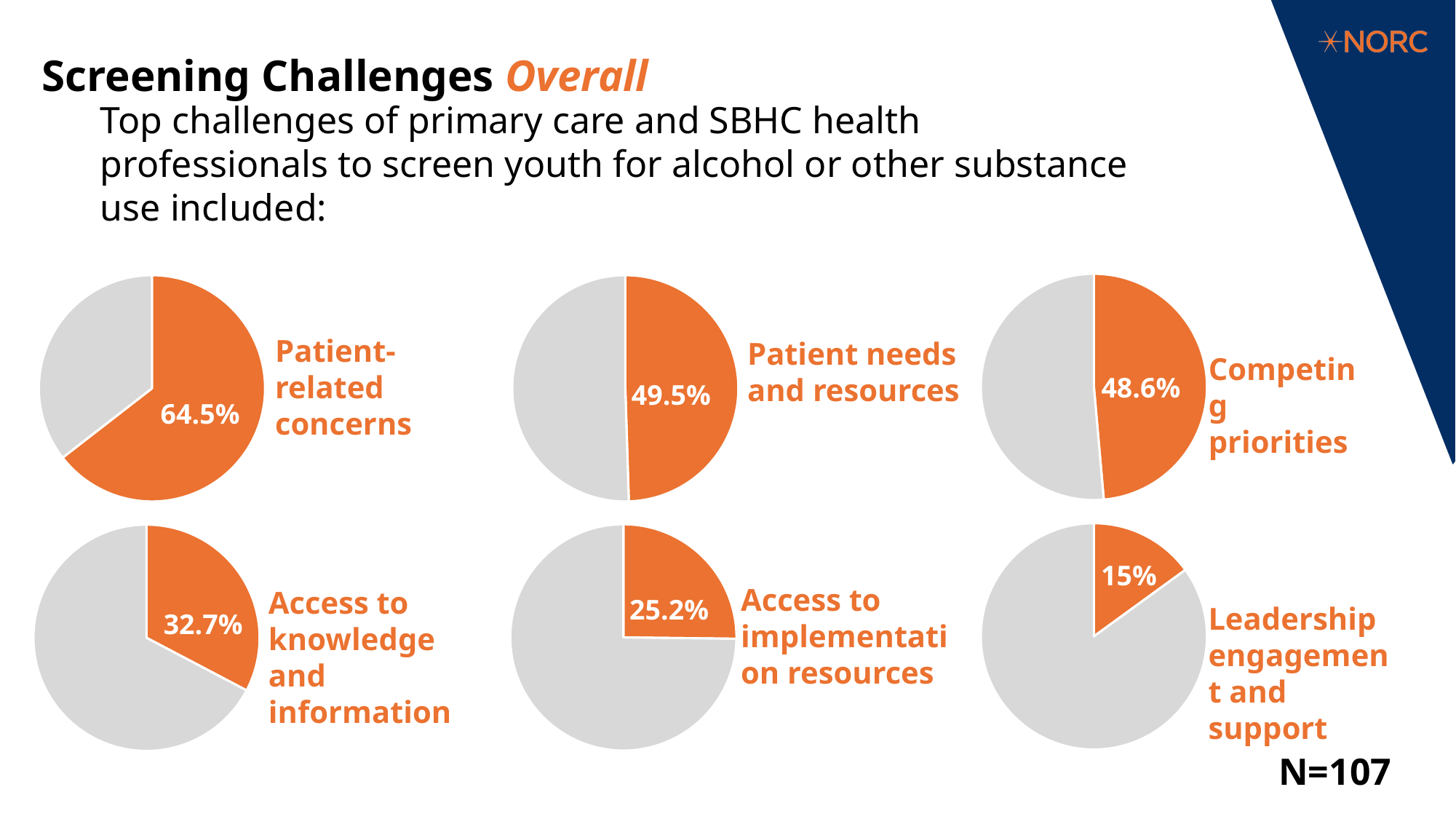
Which challenge has the highest percentage across the six pie charts? Patient-related concerns What percentage is shown for the 'Leadership engagement and support' pie chart? 15% What percentage is shown for the 'Access to implementation resources' pie chart? 25.2% What sample size (N) is shown on the slide? N=107 Which challenge has the lowest percentage across the six pie charts? Leadership engagement and support How many pie charts are shown on the slide? 6 What percentage is shown for the 'Patient-related concerns' pie chart? 64.5% What percentage is shown for the 'Competing priorities' pie chart? 48.6% What kind of chart is used to show each screening challenge? Pie chart What is the difference between the 'Patient-related concerns' percentage and the 'Access to knowledge and information' percentage? 31.8% What colour is used for the highlighted slice in each pie chart? Orange Which is larger: the percentage for 'Patient needs and resources' or for 'Access to implementation resources'? Patient needs and resources